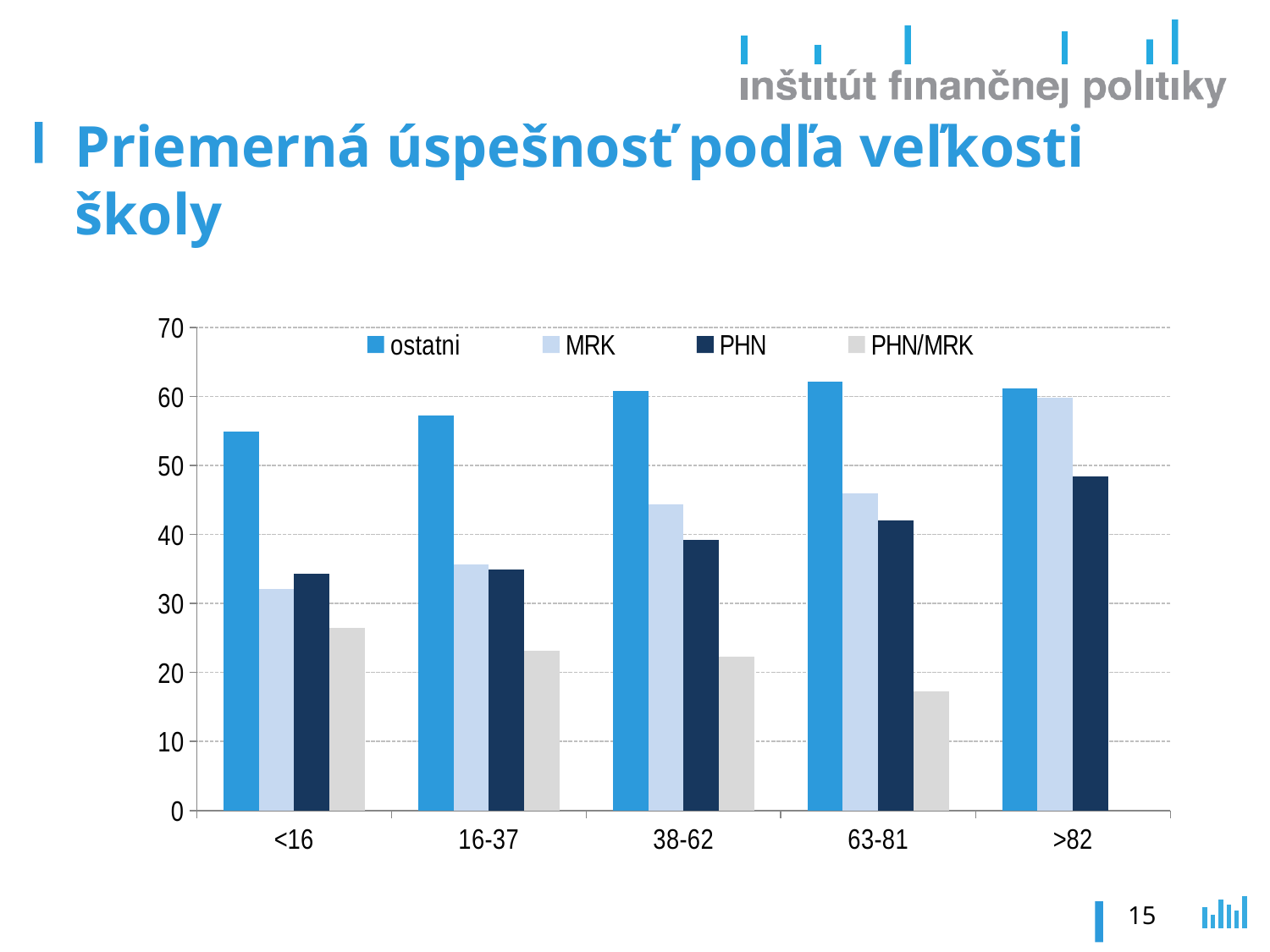
What kind of chart is shown on the slide? bar chart Do the PHN/MRK values rise or fall from <16 to 63-81? fall Is the value for MRK in the >82 category greater or less than 50? greater Which category has the lowest PHN/MRK value among those where it is plotted? 63-81 In the 38-62 category, which is larger: ostatni or MRK? ostatni Which category has the highest MRK value? >82 Is the value for ostatni in the <16 category greater or less than 50? greater Do the PHN values rise or fall as school size increases along the x axis? rise How many series does the legend list? 4 Is the value for PHN/MRK in the 63-81 category greater or less than 20? less How many school-size categories are shown on the x axis? 5 Which series is missing a bar in the >82 category? PHN/MRK